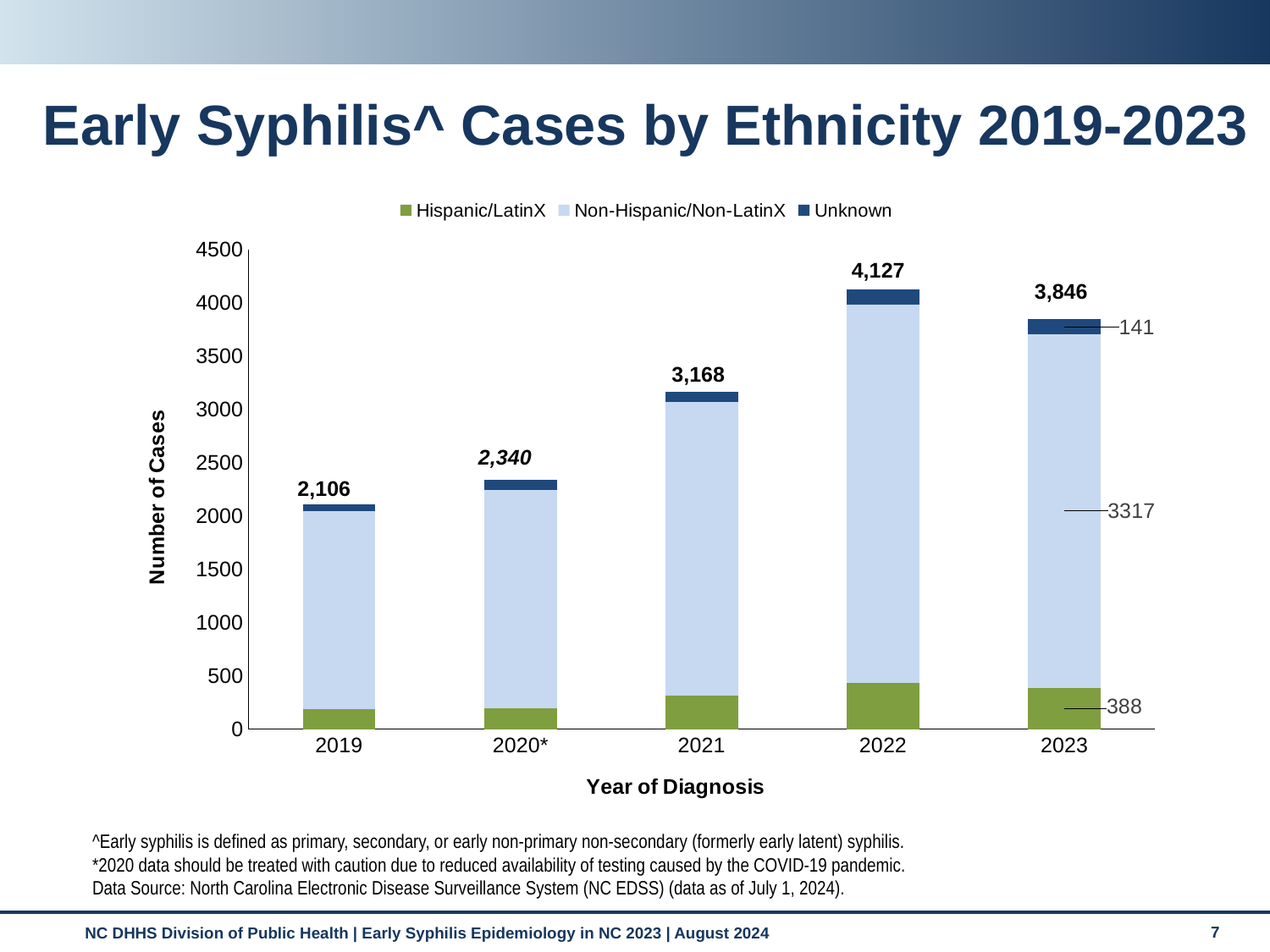
How many series does the legend list? 3 Is the value for Hispanic/LatinX cases in 2019 greater or less than 500? less How many years are shown on the x axis of the chart? 5 Which year has the highest total number of early syphilis cases? 2022 How many Hispanic/LatinX early syphilis cases are labeled for 2023? 388 How many Non-Hispanic/Non-LatinX cases are labeled for 2023? 3317 How many cases of Unknown ethnicity are labeled for 2023? 141 Is the total number of cases larger in 2023 or in 2021? 2023 Do the total cases rise or fall from 2019 to 2022? rise What is the difference between the total cases in 2022 and the total cases in 2021? 959 What is the total number of early syphilis cases shown for 2022? 4,127 Which year has the lowest total number of early syphilis cases? 2019